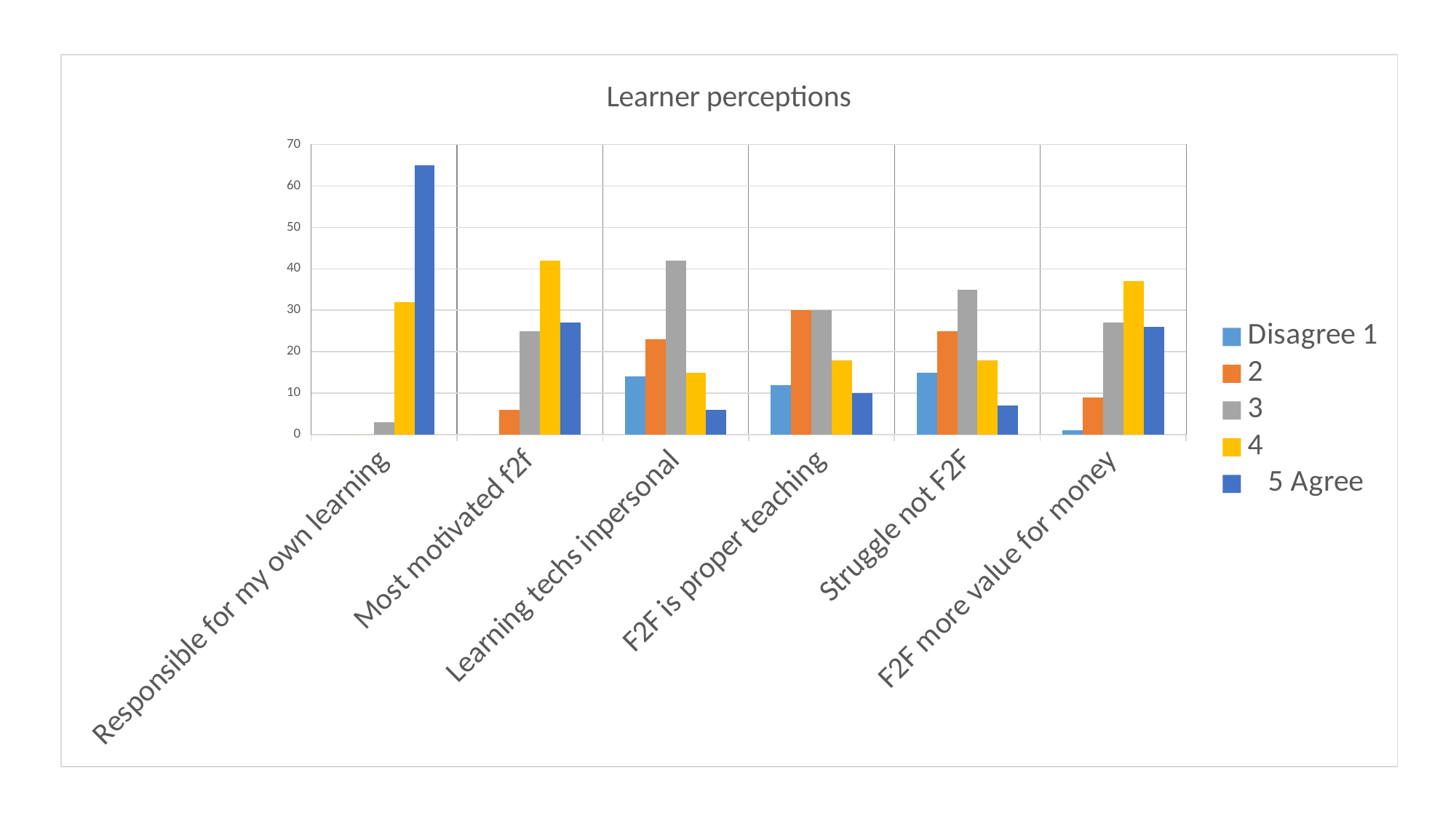
Which is larger for 'F2F more value for money': series '4' or series '5 Agree'? 4 What kind of chart is shown on the slide? bar chart What is the title of the chart? Learner perceptions Is the value of series '3' for 'Struggle not F2F' greater or less than 30? greater Which series has the lowest value for 'F2F more value for money'? Disagree 1 Is the value of series '4' for 'Learning techs inpersonal' greater or less than 20? less Is the value of '5 Agree' for 'Responsible for my own learning' greater or less than 60? greater How many series does the legend list? 5 Which series has the highest value for 'Most motivated f2f'? 4 How many categories are shown on the x axis? 6 Which series has the highest value for 'Responsible for my own learning'? 5 Agree Which series has the highest value for 'Learning techs inpersonal'? 3